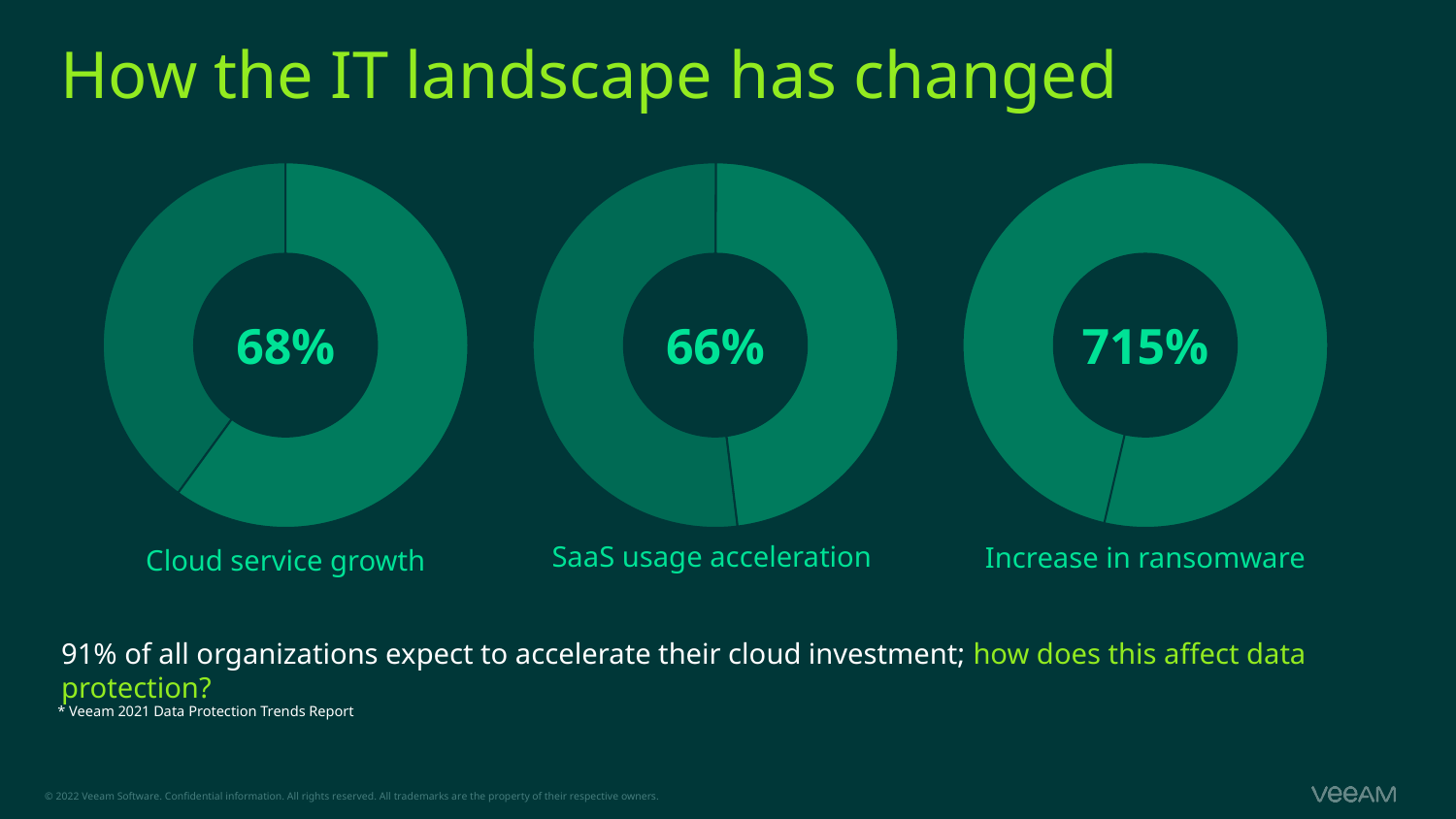
Which is larger, the value for 'Cloud service growth' or the value for 'SaaS usage acceleration'? Cloud service growth What value is shown in the center of the 'Cloud service growth' donut chart? 68% What is the difference between the 'Cloud service growth' value and the 'SaaS usage acceleration' value? 2 percentage points What value is shown in the center of the 'Increase in ransomware' donut chart? 715% How many donut charts are shown on the slide? 3 What value is shown in the center of the 'SaaS usage acceleration' donut chart? 66% What is the label beneath the rightmost donut chart? Increase in ransomware What kind of chart is used to display the three statistics on the slide? Donut (pie) chart What is the difference between the 'Increase in ransomware' value and the 'Cloud service growth' value? 647 percentage points Which of the three donut charts shows the highest value? Increase in ransomware What is the title of the slide containing the three donut charts? How the IT landscape has changed Which of the three donut charts shows the lowest value? SaaS usage acceleration